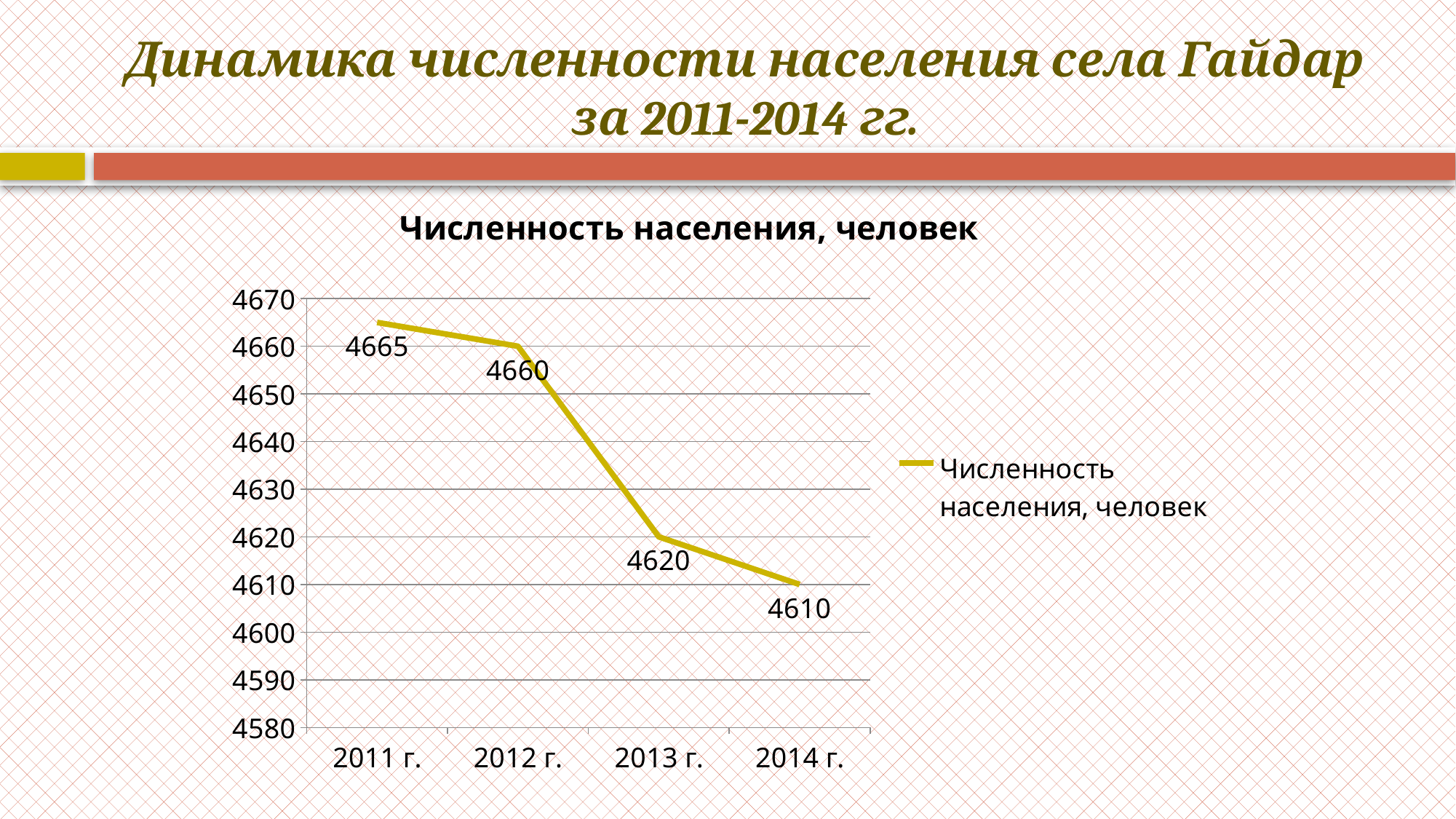
Which year has the highest population value? 2011 г. What is the population value for 2012 г.? 4660 Do the population values rise or fall from 2011 г. to 2014 г.? fall Which year has the lowest population value? 2014 г. How many years are plotted on the chart? 4 What is the difference between the population values for 2011 г. and 2014 г.? 55 What is the population value for 2011 г.? 4665 What is the difference between the population values for 2012 г. and 2013 г.? 40 What is the population value for 2014 г.? 4610 What is the population value for 2013 г.? 4620 What kind of chart is shown on the slide? line chart Which is larger, the population value for 2012 г. or for 2013 г.? 2012 г.